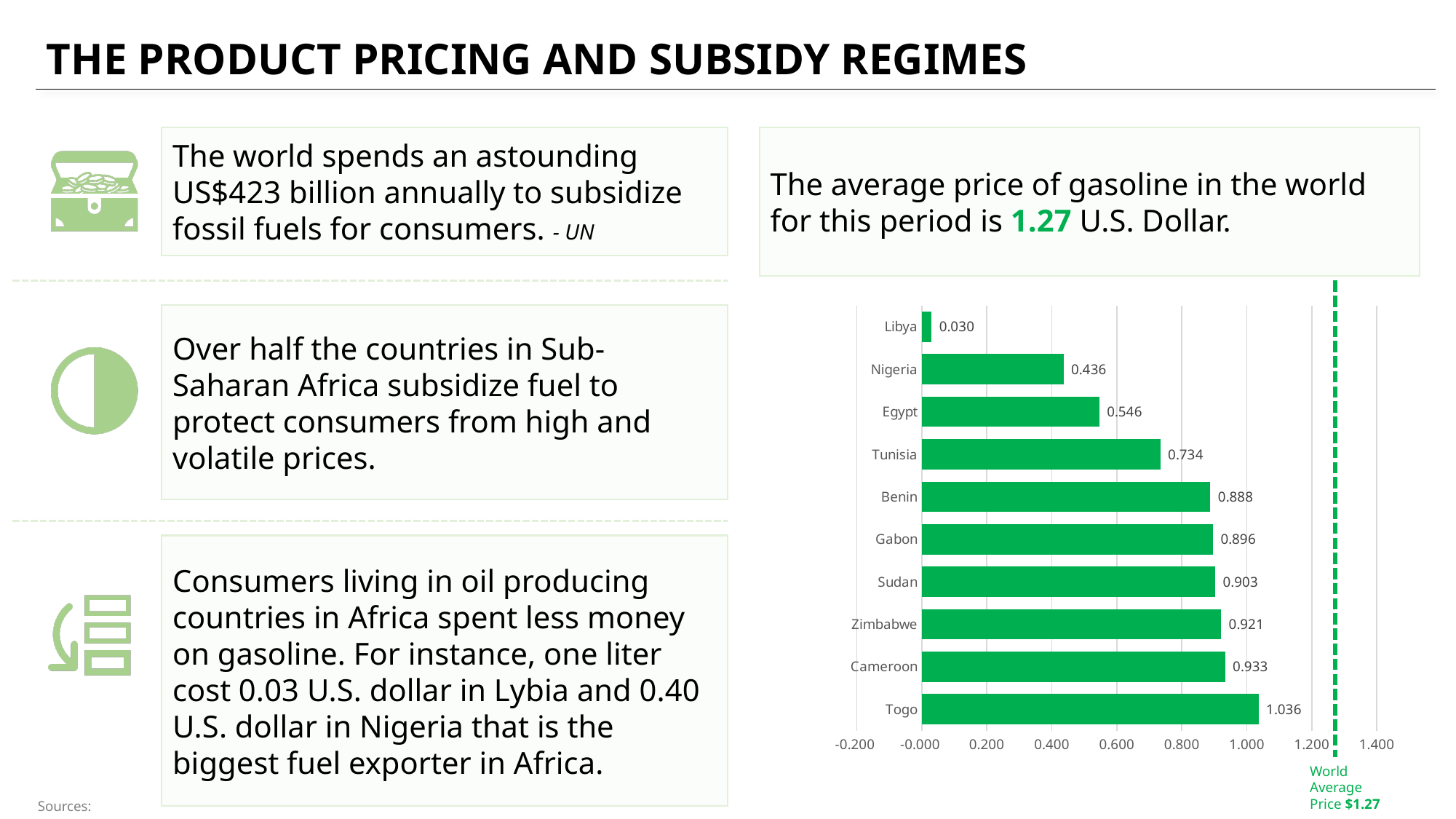
What does the dashed vertical line in the chart represent? World Average Price $1.27 What is the value for Nigeria? 0.436 What kind of chart is shown on the slide? Bar chart What is the value for Tunisia? 0.734 What is the value for Togo? 1.036 Which country has the lowest value? Libya Which has a larger value, Tunisia or Egypt? Tunisia What is the difference between the values for Egypt and Nigeria? 0.110 What is the difference between the values for Togo and Libya? 1.006 What is the value for Libya? 0.030 Which country has the highest value? Togo How many countries are shown in the chart? 10